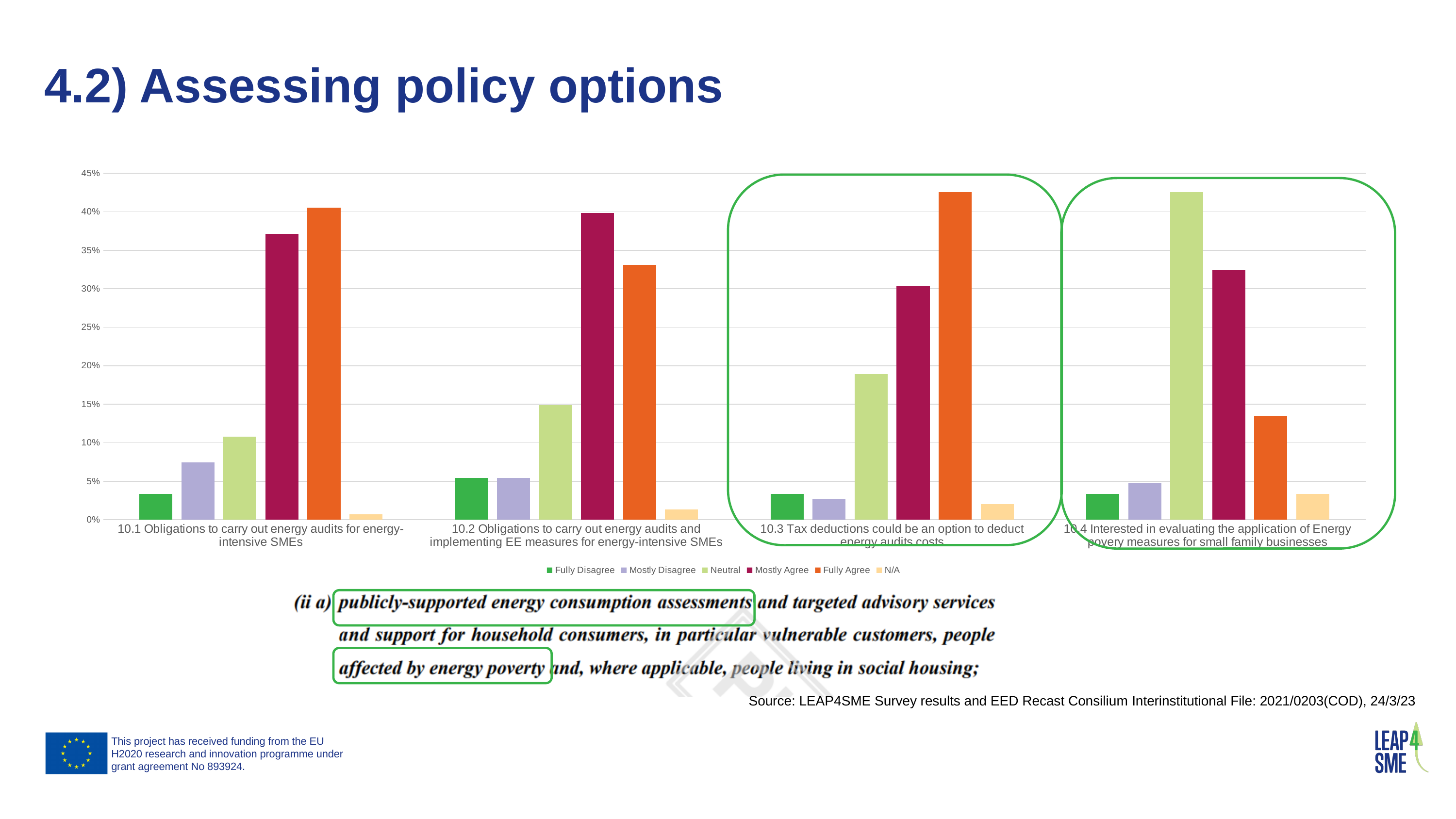
For option 10.3 (Tax deductions for energy audit costs), which response has the highest share? Fully Agree Is the Fully Agree value for option 10.4 greater or less than 15%? less How many series does the legend list? 6 Which is larger: the Fully Agree value for option 10.1 or the Fully Agree value for option 10.4? Option 10.1 What colour represents the Fully Agree series in the legend? Orange For option 10.4 (Energy poverty measures for small family businesses), which response has the highest share? Neutral What kind of chart is shown on the slide? Bar chart Is the Fully Agree value for option 10.3 greater or less than 40%? greater Is the Mostly Agree value for option 10.4 greater or less than 30%? greater How many policy options (categories) are shown on the x axis? 4 For option 10.2, which is larger: Mostly Agree or Fully Agree? Mostly Agree For option 10.1, which response has the lowest share? N/A